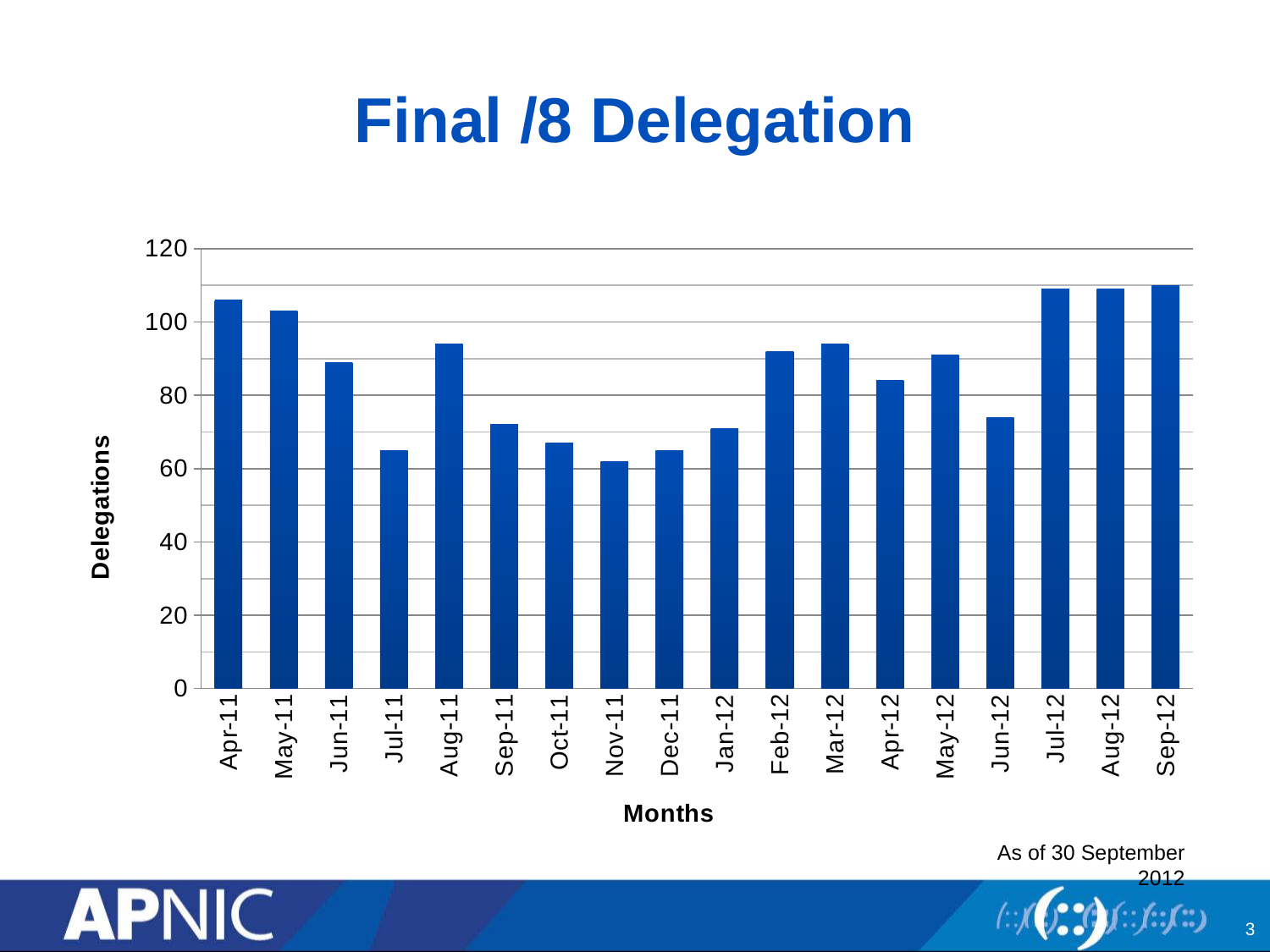
Is the value for Sep-12 greater or less than 100? greater Is the value for Jul-11 greater or less than 80? less Which has a higher value, Feb-12 or Jun-12? Feb-12 What is the title of the chart? Final /8 Delegation Do the values rise or fall from Apr-11 to Jul-11? fall What kind of chart is shown on the slide? bar chart Is the value for Apr-11 greater or less than 100? greater What is the label on the y axis? Delegations How many months are plotted on the x axis? 18 Which has a higher value, Apr-11 or Jul-11? Apr-11